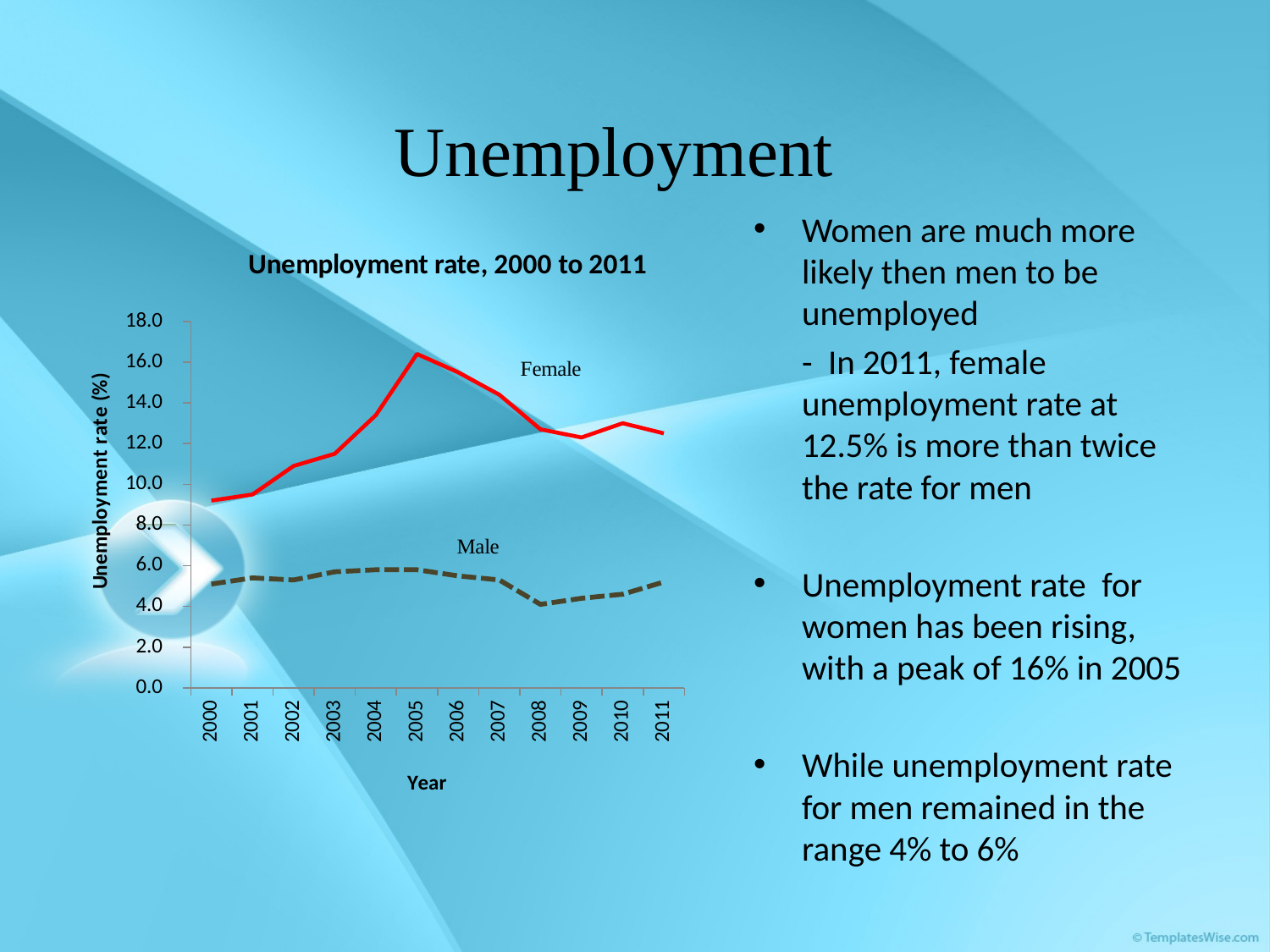
In which year does the Male series have its lowest value? 2008 Is the value for Male in 2008 greater or less than 6.0? less In which year does the Female series have its lowest value? 2000 What is the title of the chart? Unemployment rate, 2000 to 2011 Is the value for Female in 2005 greater or less than 14.0? greater How many years are shown on the x axis of the chart? 12 How many series are plotted on the chart? 2 Which series has the higher value in 2011, Female or Male? Female What kind of chart is shown on the slide? line chart Does the Female series rise or fall between 2000 and 2005? rise What is the label on the y axis of the chart? Unemployment rate (%) In which year does the Female series reach its highest value? 2005